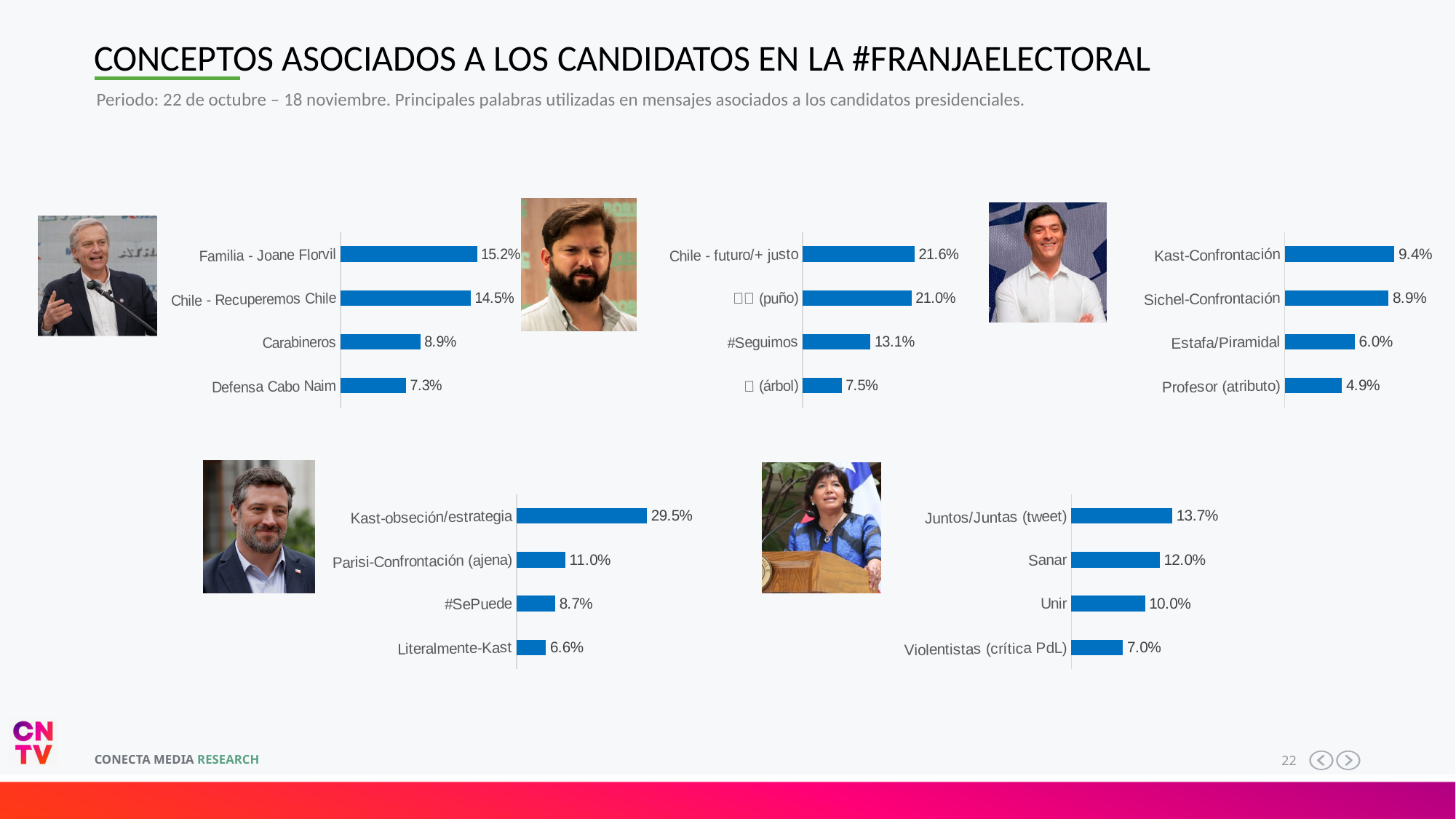
In the top-right chart, what is the value for Estafa/Piramidal? 6.0% In the top-right chart, which category has the lowest value? Profesor (atributo) In the bottom-right chart, what is the value for Unir? 10.0% In the bottom-right chart, what is the difference between Juntos/Juntas (tweet) and Violentistas (crítica PdL)? 6.7% What kind of chart is the top-left chart? Bar chart In the bottom-left chart, which is larger: Parisi-Confrontación (ajena) or #SePuede? Parisi-Confrontación (ajena) In the top-middle chart, what is the difference between Chile - futuro/+ justo and #Seguimos? 8.5% In the bottom-left chart, what is the value for Kast-obseción/estrategia? 29.5% In the top-left chart, what is the value for Carabineros? 8.9% How many categories does the bottom-right chart show? 4 In the top-middle chart, what is the value for #Seguimos? 13.1% In the top-left chart, which category has the highest value? Familia - Joane Florvil